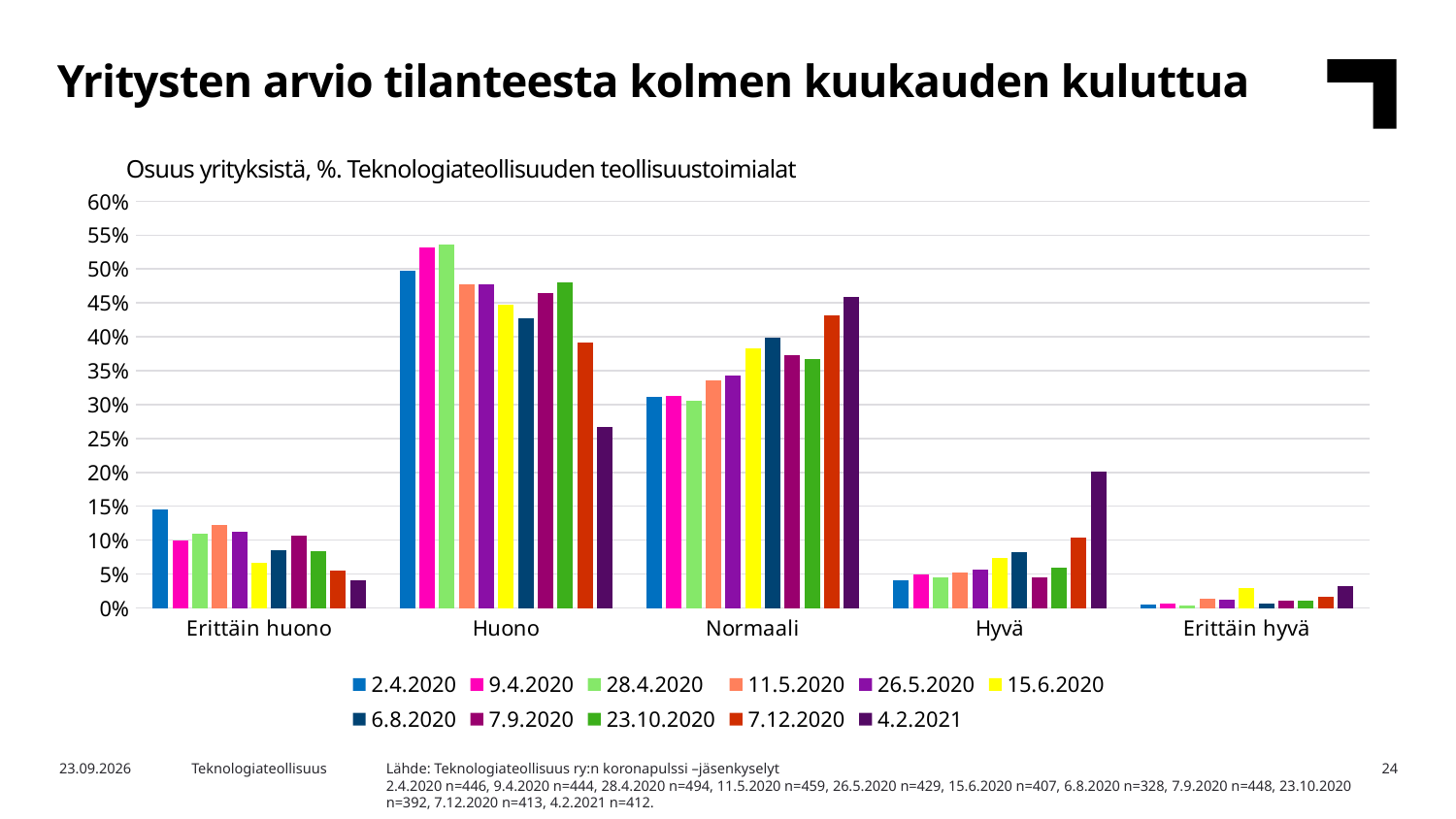
Which category has the lowest value in the 2.4.2020 series? Erittäin hyvä What is the first series listed in the legend? 2.4.2020 In the 4.2.2021 series, which is larger: the value for Normaali or the value for Huono? Normaali How many categories are shown on the x axis? 5 Which category has the highest value in the 4.2.2021 series? Normaali Is the value for Erittäin huono in the 2.4.2020 series greater or less than 10%? greater Across the survey dates from 2.4.2020 to 4.2.2021, does the value for Huono generally rise or fall? fall Which category has the highest value in the 2.4.2020 series? Huono Is the value for Huono in the 4.2.2021 series greater or less than 30%? less Is the value for Hyvä in the 4.2.2021 series greater or less than 15%? greater How many series does the legend list? 11 What kind of chart is shown on the slide? bar chart